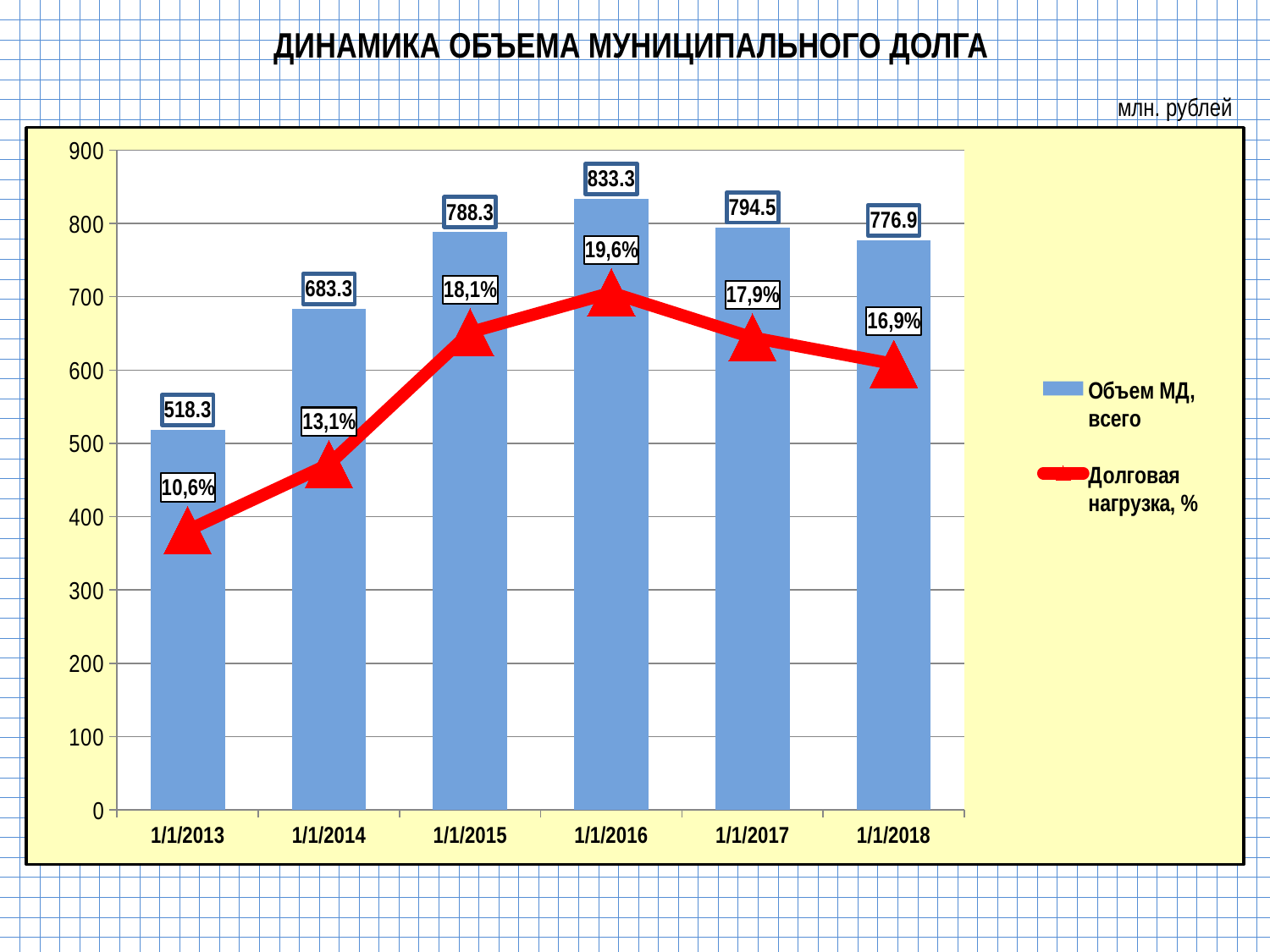
Which date has the lowest Долговая нагрузка, %? 1/1/2013 Which date has the highest Объем МД, всего? 1/1/2016 How many series does the legend list? 2 What is the value of Объем МД, всего for 1/1/2018? 776.9 What is the Долговая нагрузка, % value for 1/1/2013? 10,6% How many dates are shown on the x axis? 6 What is the title of the chart? ДИНАМИКА ОБЪЕМА МУНИЦИПАЛЬНОГО ДОЛГА Is the Объем МД, всего bar for 1/1/2014 greater or less than 700? less What is the difference between Объем МД, всего for 1/1/2016 and 1/1/2013? 315 Which is larger, Объем МД, всего for 1/1/2015 or for 1/1/2017? 1/1/2017 What is the value of Объем МД, всего for 1/1/2016? 833.3 Does Долговая нагрузка, % rise or fall from 1/1/2016 to 1/1/2018? fall